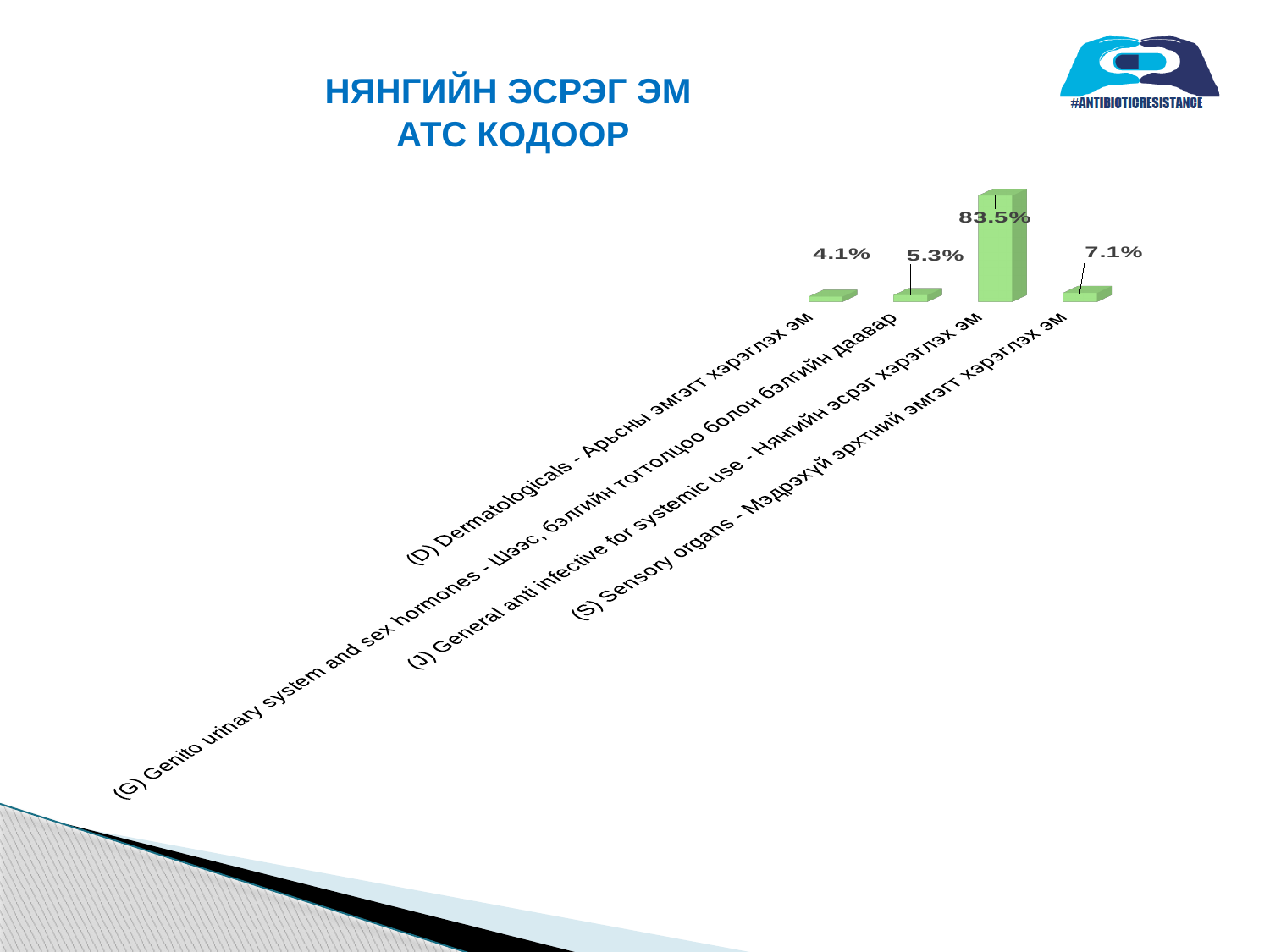
What is the value for (S) Sensory organs? 7.1% What is the value for (J) General anti infective for systemic use? 83.5% How many categories are shown in the chart? 4 What is the value for (D) Dermatologicals? 4.1% What is the difference between the values for (G) Genito urinary system and sex hormones and (D) Dermatologicals? 1.2% What is the difference between the values for (J) General anti infective for systemic use and (S) Sensory organs? 76.4% What kind of chart is shown on the slide? Bar chart Which is larger, the value for (S) Sensory organs or the value for (G) Genito urinary system and sex hormones? (S) Sensory organs Which category has the lowest value? (D) Dermatologicals What is the value for (G) Genito urinary system and sex hormones? 5.3% Which category has the highest value? (J) General anti infective for systemic use What is the title of the slide? НЯНГИЙН ЭСРЭГ ЭМ ATC КОДООР